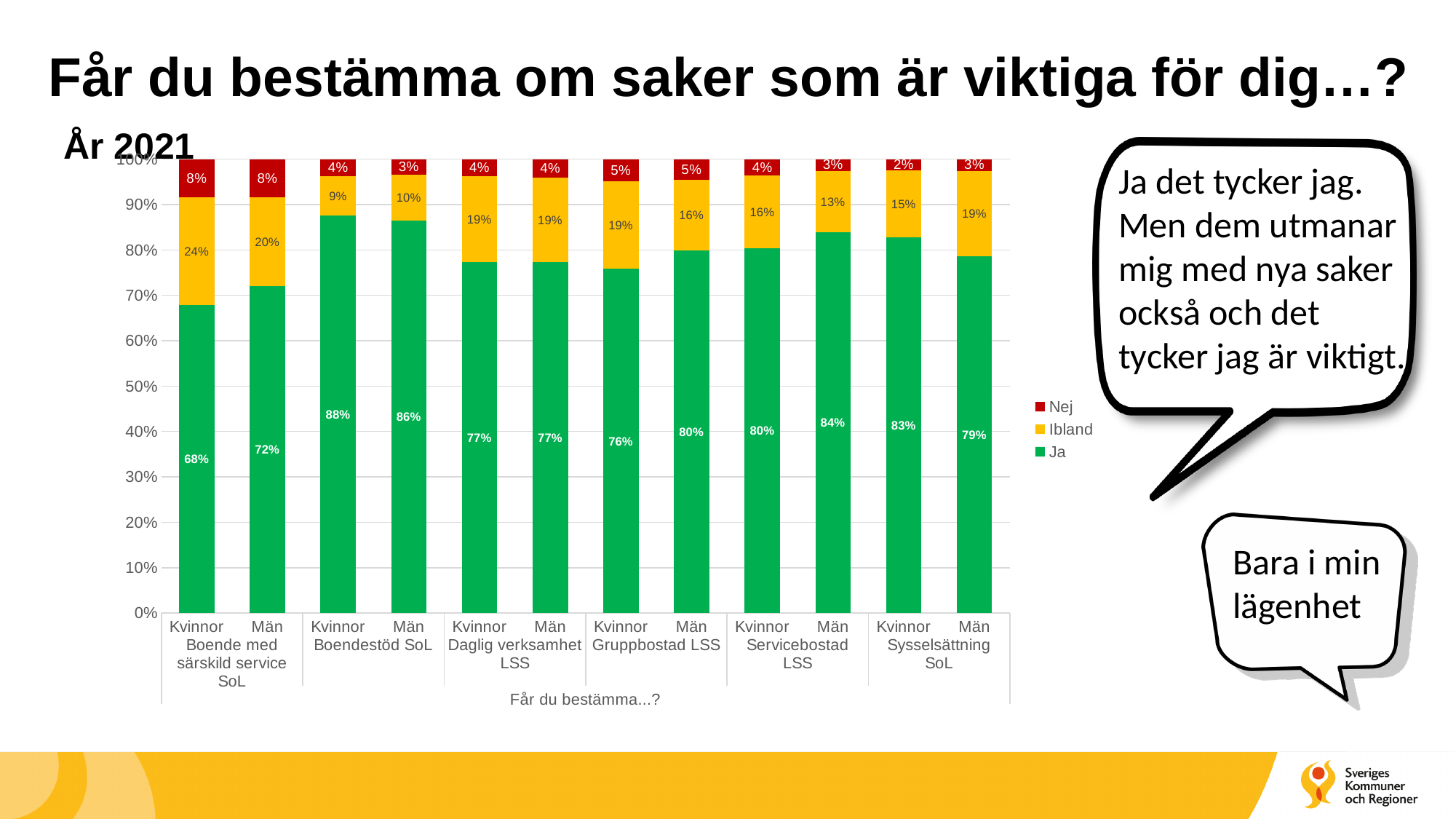
Which bar has the highest Ja share? Kvinnor, Boendestöd SoL (88%) What are the three legend entries of the chart? Nej, Ibland, Ja Which has a larger Ibland share: Kvinnor in Boende med särskild service SoL or Kvinnor in Boendestöd SoL? Kvinnor in Boende med särskild service SoL (24%) How many series does the legend list? 3 Which has a larger Ja share: Kvinnor or Män in Gruppbostad LSS? Män (80%) What is the Nej share for Kvinnor in Sysselsättning SoL? 2% What is the difference in the Ja share between Män and Kvinnor in Servicebostad LSS? 4 percentage points How many bars are shown in the chart? 12 Which bar has the lowest Ja share? Kvinnor, Boende med särskild service SoL (68%) What type of chart is shown? Stacked bar chart What percentage of Kvinnor in Boende med särskild service SoL answered Ja? 68% What is the Ibland share for Män in Boendestöd SoL? 10%